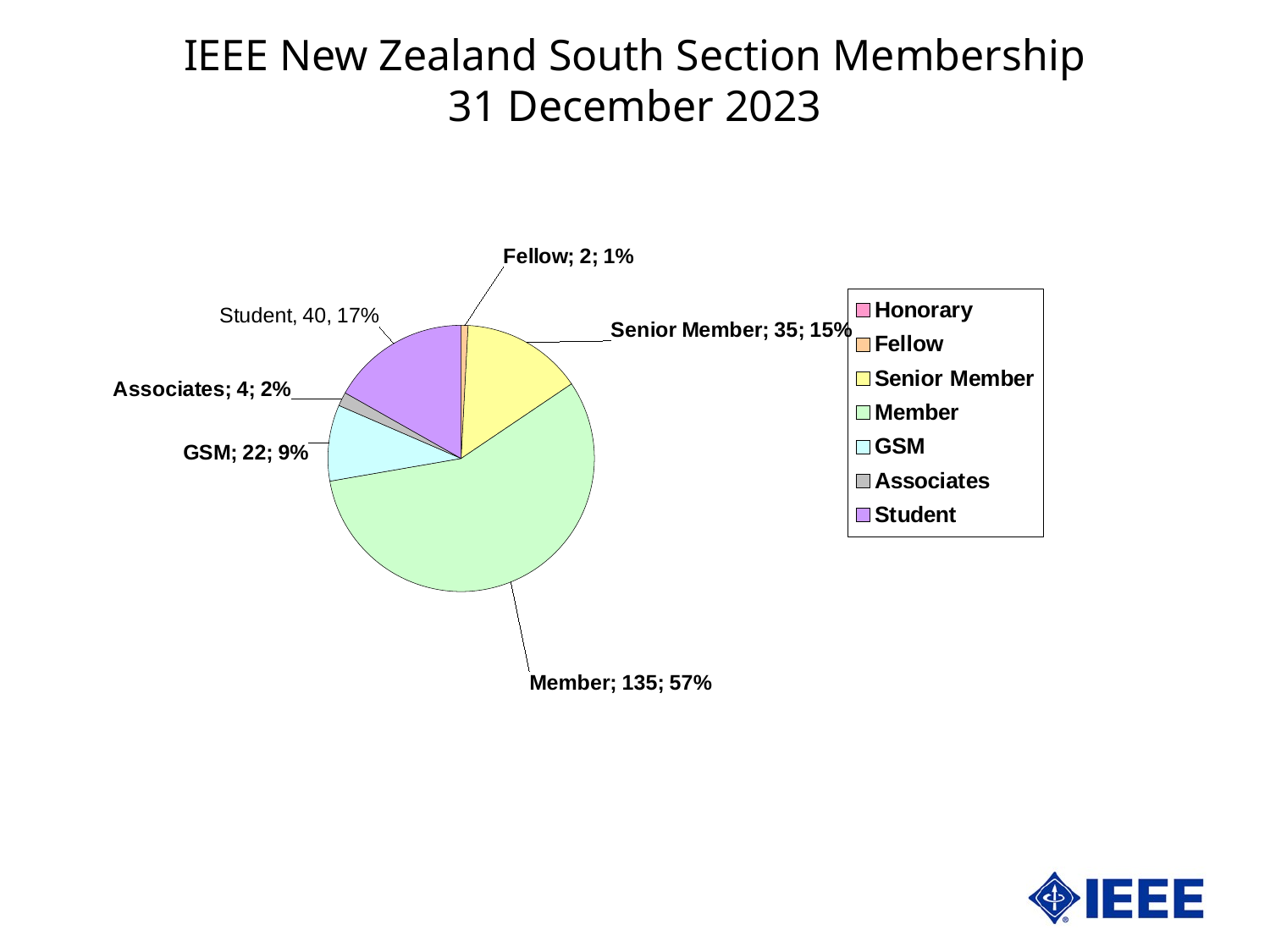
How many entries does the legend list? 7 How many members are in the Member category? 135 Of the slices with data labels, which category has the smallest value? Fellow What share of the pie does the Member slice represent? 57% What date is given in the chart title? 31 December 2023 What kind of chart is shown on the slide? pie chart Which is larger, the Student value or the Senior Member value? Student What is the difference between the Senior Member value and the GSM value? 13 What is the value shown for Student? 40 What is the value shown for Associates? 4 Which category has the largest slice of the pie? Member What percentage share is shown for GSM? 9%